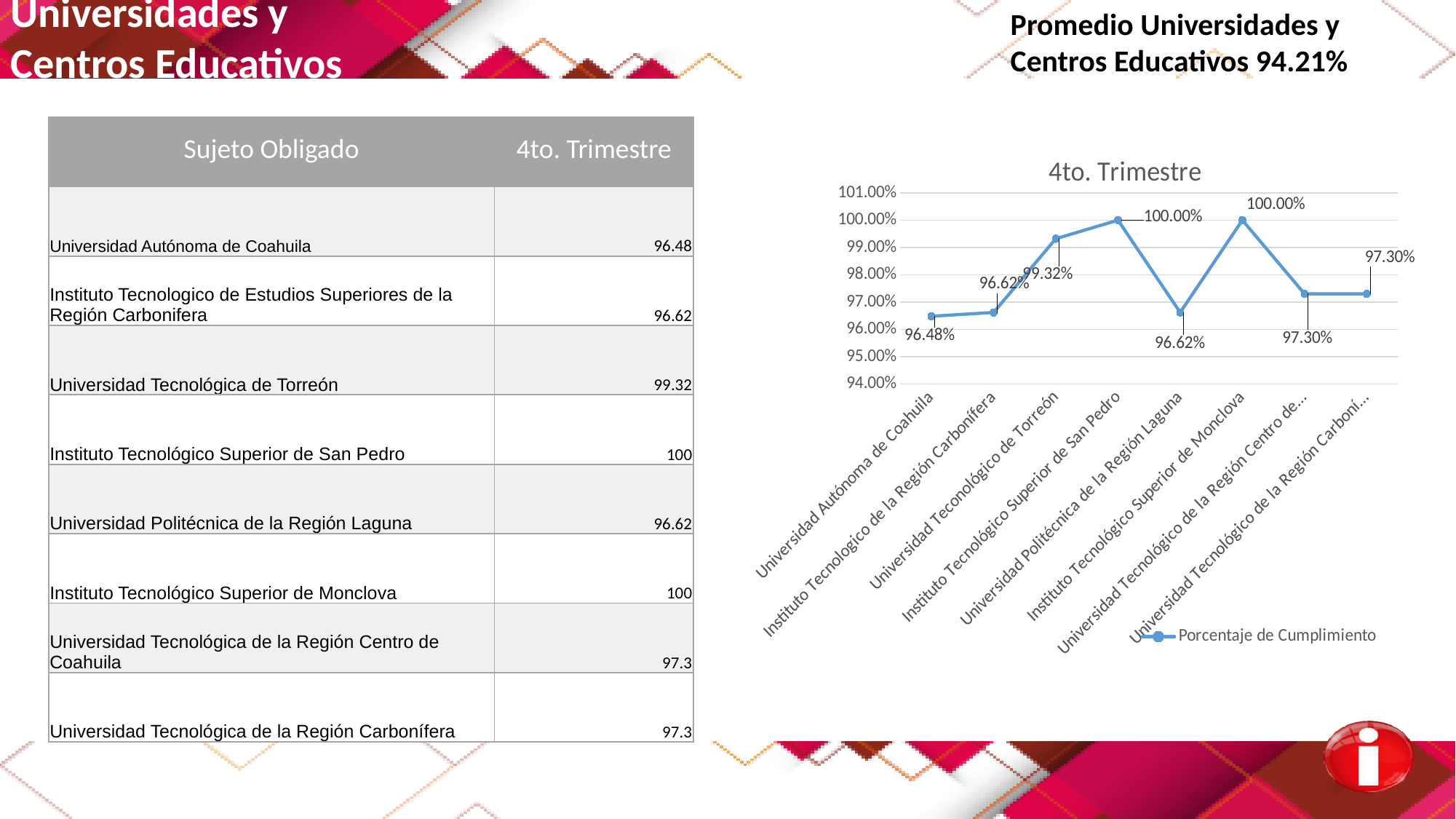
What is the value for Instituto Tecnológico Superior de Monclova in the chart? 100.00% Which has a larger value, Instituto Tecnológico Superior de San Pedro or Universidad Politécnica de la Región Laguna? Instituto Tecnológico Superior de San Pedro What series name does the chart legend show? Porcentaje de Cumplimiento What is the title of the chart? 4to. Trimestre How many series does the chart legend list? 1 What is the value for Universidad Tecnológico de Torreón in the chart? 99.32% How many categories are plotted along the x axis of the chart? 8 What is the difference between the values for Universidad Tecnológico de Torreón and Universidad Autónoma de Coahuila? 2.84 percentage points What is the highest value plotted in the chart? 100.00% What type of chart is shown on the slide? Line chart What is the value for Universidad Autónoma de Coahuila in the chart? 96.48% Which category has the lowest value in the chart? Universidad Autónoma de Coahuila